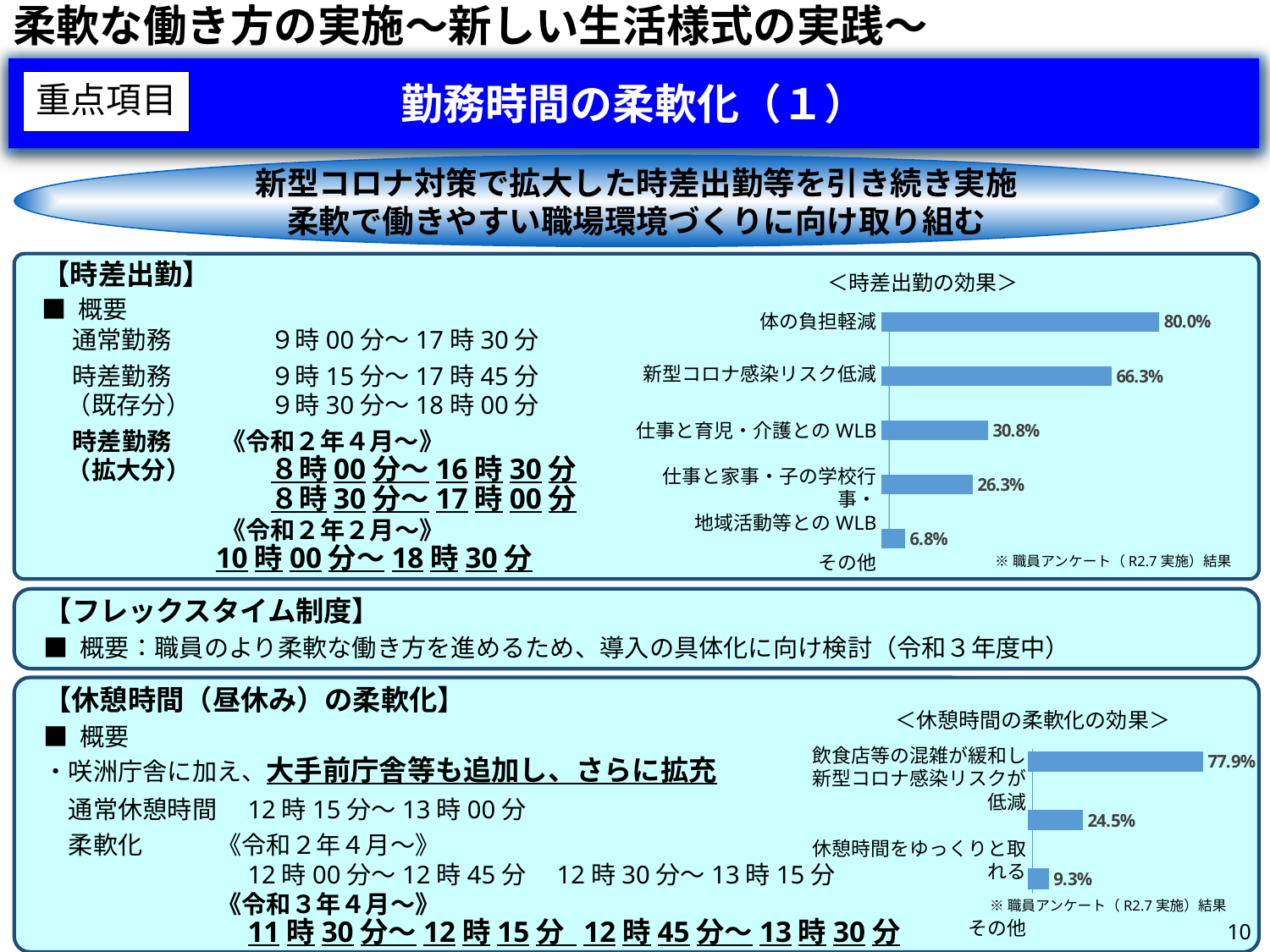
「時差出勤の効果」のグラフで、最も値が高い項目はどれですか？ 体の負担軽減 「時差出勤の効果」のグラフで、「新型コロナ感染リスク低減」の値はいくつですか？ 66.3% 「時差出勤の効果」のグラフで、最も値が低い項目はどれですか？ その他 「休憩時間の柔軟化の効果」のグラフで、最も値が高い項目はどれですか？ 飲食店等の混雑が緩和し新型コロナ感染リスクが低減 「時差出勤の効果」のグラフで、「体の負担軽減」の値はいくつですか？ 80.0% 「時差出勤の効果」のグラフで、「仕事と育児・介護とのWLB」と「その他」ではどちらの値が大きいですか？ 仕事と育児・介護とのWLB 「休憩時間の柔軟化の効果」のグラフで、「休憩時間をゆっくりと取れる」の値はいくつですか？ 24.5% 「休憩時間の柔軟化の効果」のグラフで、「休憩時間をゆっくりと取れる」と「その他」の差はいくつですか？ 15.2% 「休憩時間の柔軟化の効果」のグラフには項目がいくつありますか？ 3 「時差出勤の効果」のグラフで、「体の負担軽減」と「新型コロナ感染リスク低減」の差はいくつですか？ 13.7% 「時差出勤の効果」のグラフはどの種類のグラフですか？ 棒グラフ 「時差出勤の効果」のグラフには項目がいくつありますか？ 5